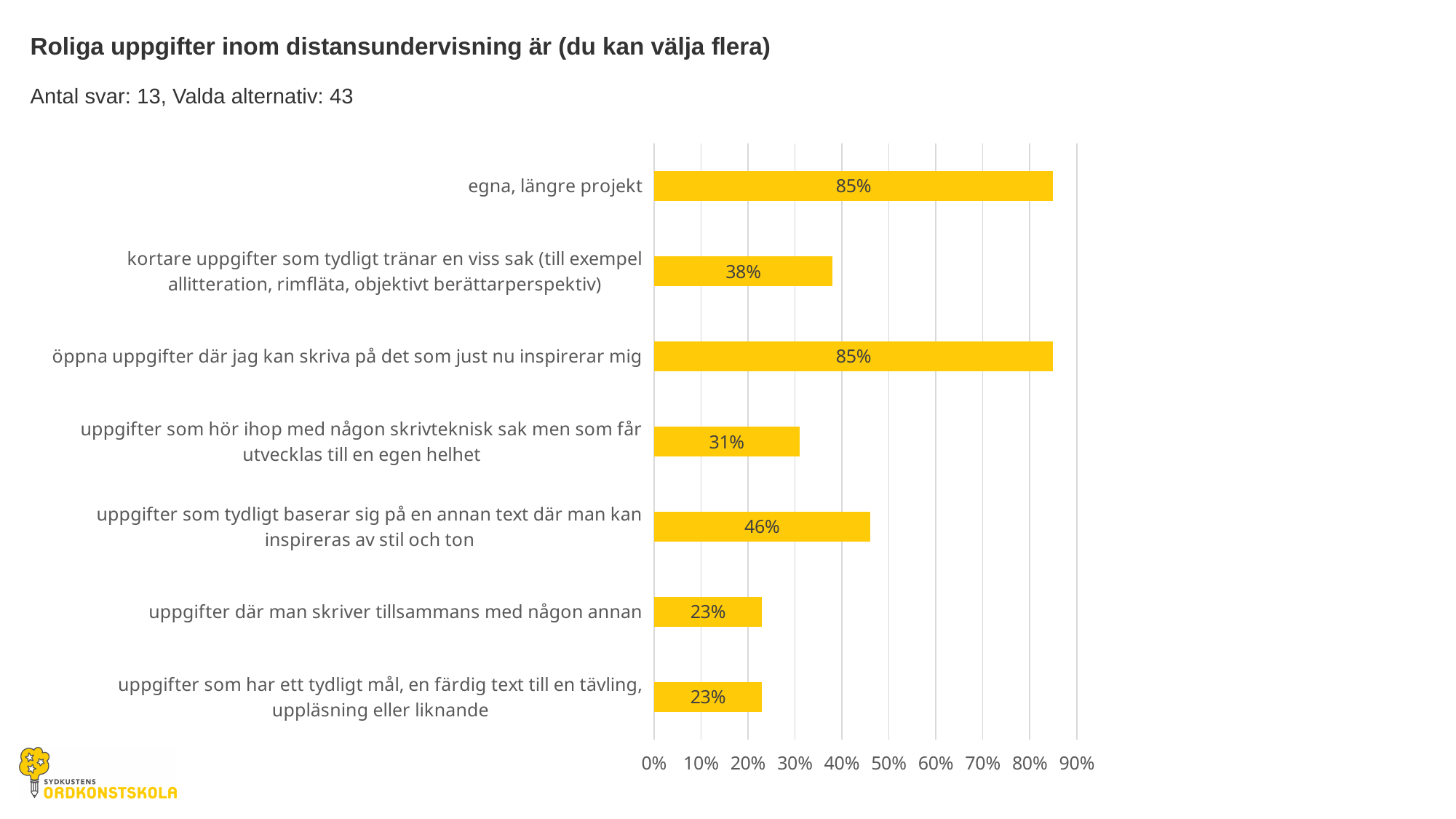
How many categories are shown on the chart? 7 What is the value for "egna, längre projekt"? 85% What is the value for "uppgifter där man skriver tillsammans med någon annan"? 23% What is the title of the chart? Roliga uppgifter inom distansundervisning är (du kan välja flera) What is the value for "uppgifter som hör ihop med någon skrivteknisk sak men som får utvecklas till en egen helhet"? 31% Is the value for "kortare uppgifter som tydligt tränar en viss sak" greater or less than 30%? greater Which has a larger value: "uppgifter som tydligt baserar sig på en annan text" or "uppgifter som hör ihop med någon skrivteknisk sak"? uppgifter som tydligt baserar sig på en annan text What is the difference between the value for "egna, längre projekt" and the value for "kortare uppgifter som tydligt tränar en viss sak"? 47% What is the highest value shown on the chart? 85% What is the value for "uppgifter som tydligt baserar sig på en annan text där man kan inspireras av stil och ton"? 46% What kind of chart is shown on the slide? bar chart What is the lowest value shown on the chart? 23%